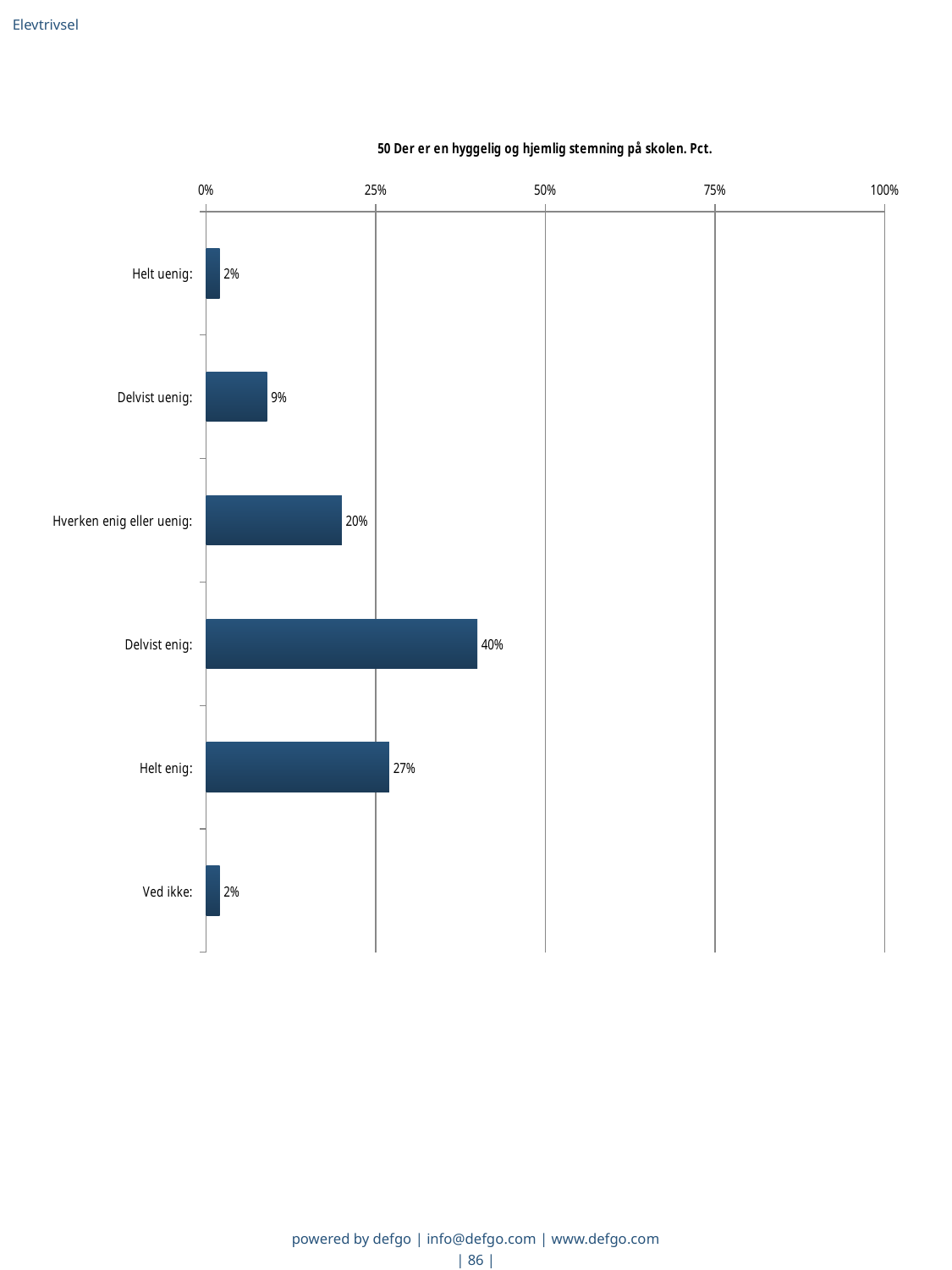
What is the value for "Delvist uenig:"? 9% What is the value for "Helt enig:"? 27% What is the difference between the values for "Delvist enig:" and "Helt enig:"? 13% How many categories are shown in the chart? 6 Which category has the highest value? Delvist enig: Is the value for "Delvist enig:" greater or less than 25%? greater What kind of chart is shown on the slide? bar chart Which is larger, the value for "Hverken enig eller uenig:" or the value for "Helt enig:"? Helt enig: What is the title of the chart? 50 Der er en hyggelig og hjemlig stemning på skolen. Pct. What is the value for "Hverken enig eller uenig:"? 20% What is the difference between the values for "Hverken enig eller uenig:" and "Delvist uenig:"? 11% What is the value for "Delvist enig:"? 40%